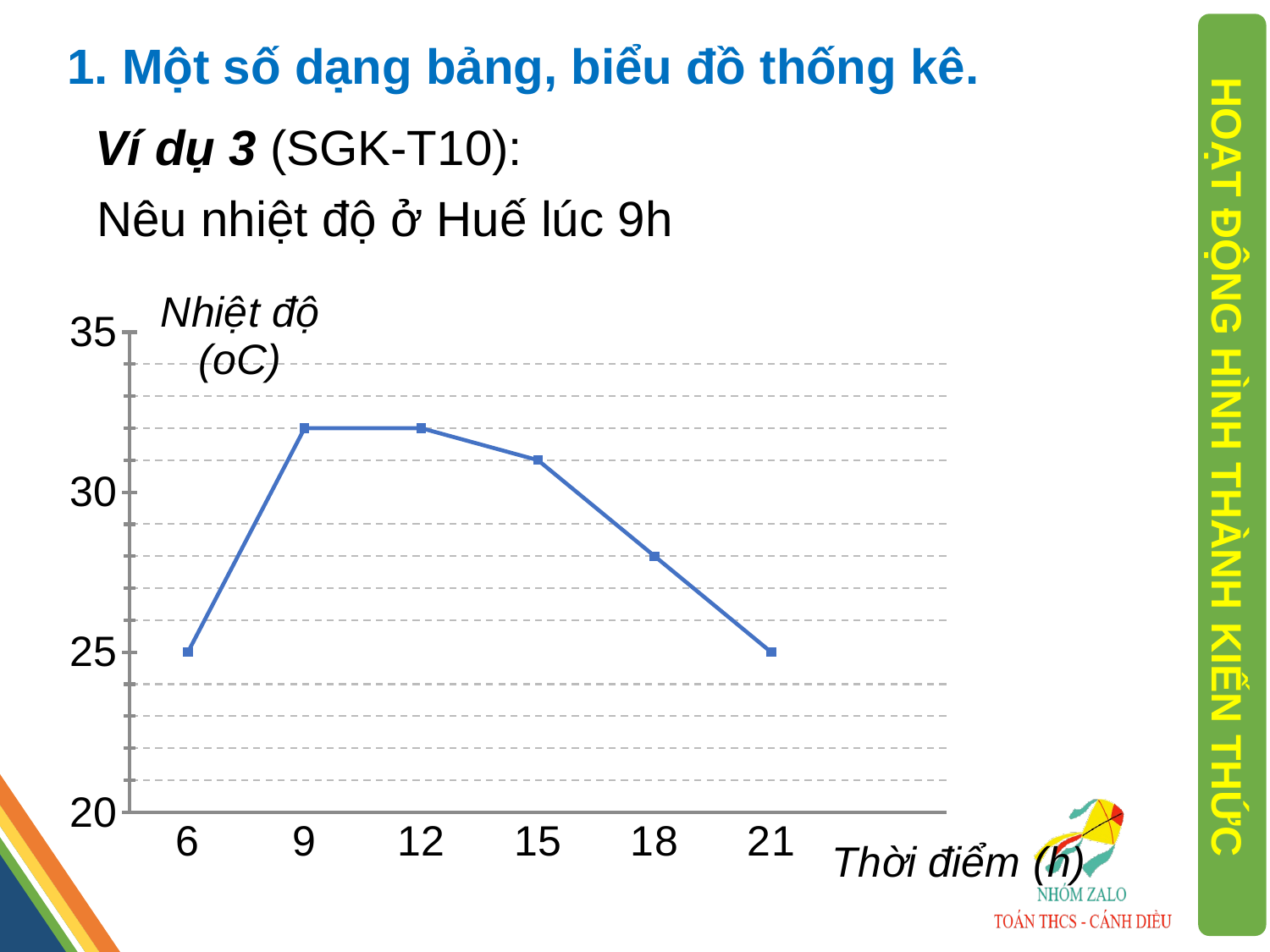
What kind of chart is shown on the slide? line chart Is the value at 18h greater or less than 30? less Is the value at 15h greater or less than 30? greater Which time has the higher temperature, 9h or 18h? 9h Do the values rise or fall from 6h to 9h? rise Do the values rise or fall from 12h to 21h? fall What is the temperature at 21h on the chart? 25 Which time has the higher temperature, 15h or 18h? 15h What is the label on the horizontal axis of the chart? Thời điểm (h) How many data points are plotted on the line chart? 6 What is the temperature at 6h on the chart? 25 Is the value at 9h greater or less than 30? greater